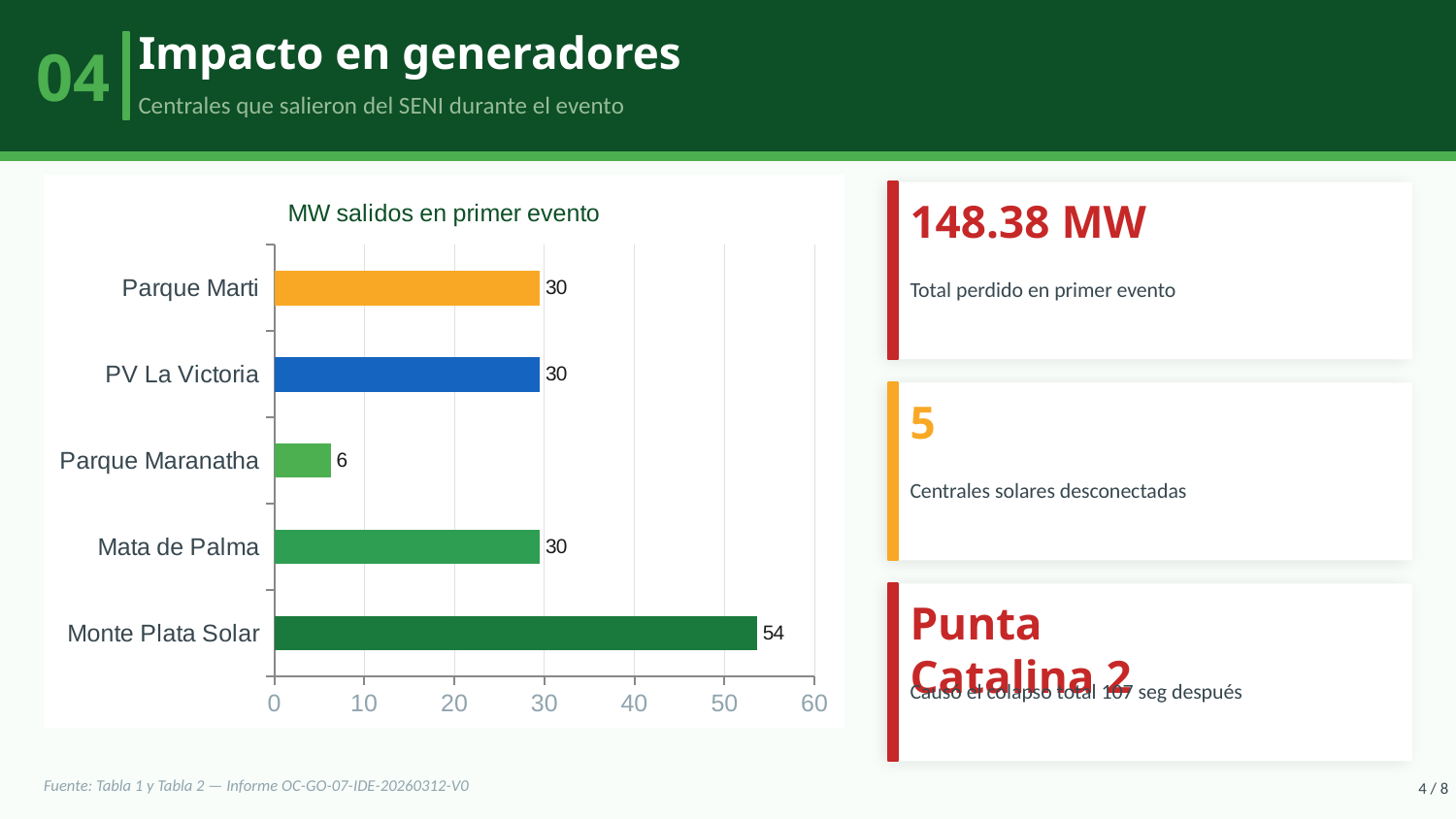
Which is larger, the value for Monte Plata Solar or the value for Parque Marti? Monte Plata Solar Which category has the highest value in the chart? Monte Plata Solar What is the difference between the values for Monte Plata Solar and Mata de Palma? 24 What is the value for PV La Victoria in the chart? 30 What is the value for Parque Maranatha in the chart? 6 What kind of chart is shown on the slide? bar chart What is the value for Monte Plata Solar in the chart? 54 What is the difference between the values for Parque Marti and Parque Maranatha? 24 Is the value for Monte Plata Solar greater or less than 50? greater Which category has the lowest value in the chart? Parque Maranatha What is the title of the chart? MW salidos en primer evento How many categories are shown in the chart? 5